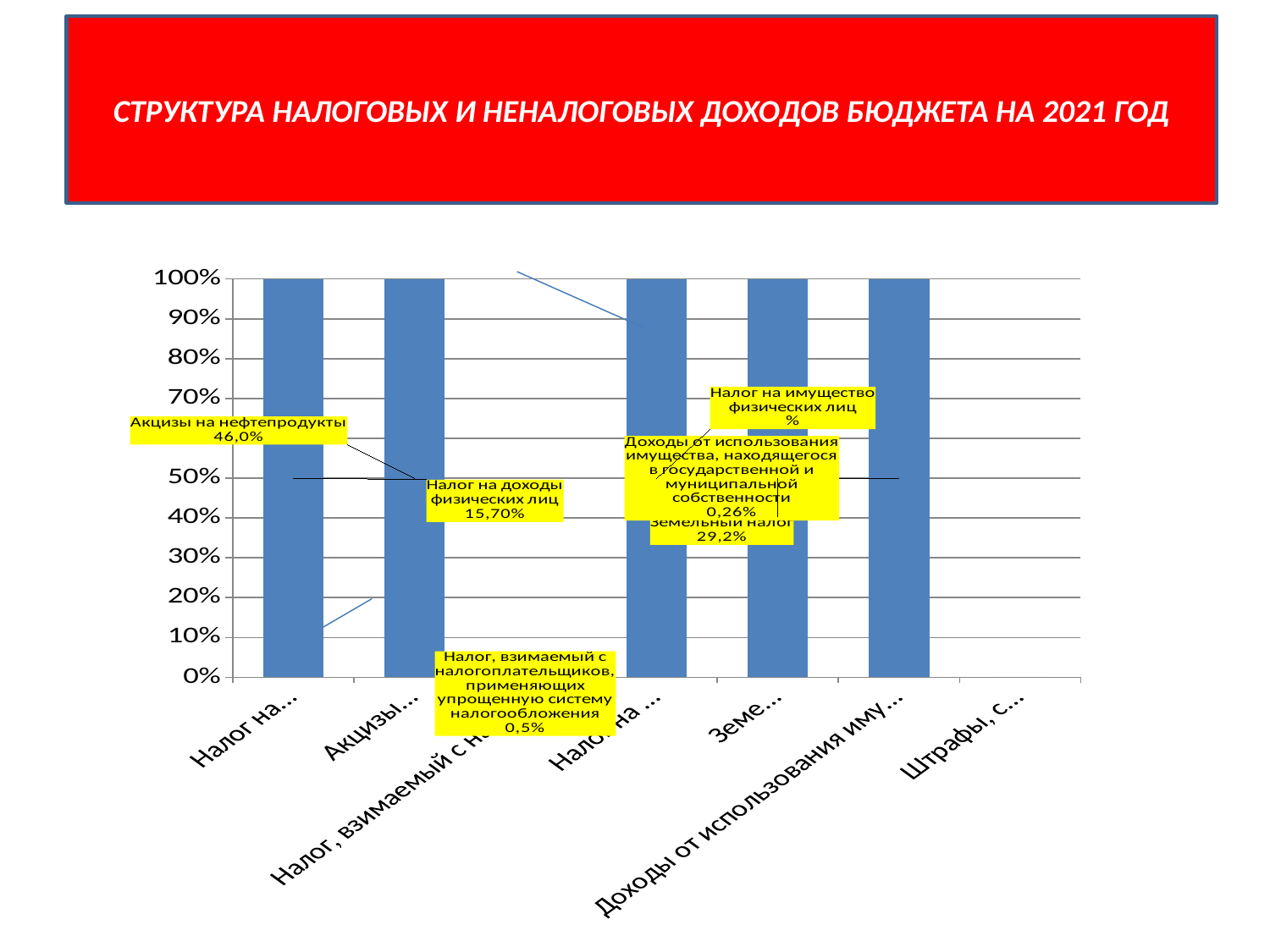
What kind of chart is shown on the slide? bar chart Which is larger according to the data labels: Налог на доходы физических лиц or Земельный налог? Земельный налог What is the difference between the labelled values for Акцизы на нефтепродукты (46,0%) and Земельный налог (29,2%)? 16,8% What is the value shown in the data label for Налог, взимаемый с налогоплательщиков, применяющих упрощенную систему налогообложения? 0,5% What is the value shown in the data label for Налог на доходы физических лиц? 15,70% What is the value shown in the data label for Акцизы на нефтепродукты? 46,0% What is the value shown in the data label for Доходы от использования имущества, находящегося в государственной и муниципальной собственности? 0,26% How many category labels are shown along the x axis of the chart? 7 Which is larger according to the data labels: Акцизы на нефтепродукты or Земельный налог? Акцизы на нефтепродукты What is the highest value shown on the vertical axis of the chart? 100% What is the value shown in the data label for Земельный налог? 29,2% What is the title of the slide containing the chart? СТРУКТУРА НАЛОГОВЫХ И НЕНАЛОГОВЫХ ДОХОДОВ БЮДЖЕТА НА 2021 ГОД